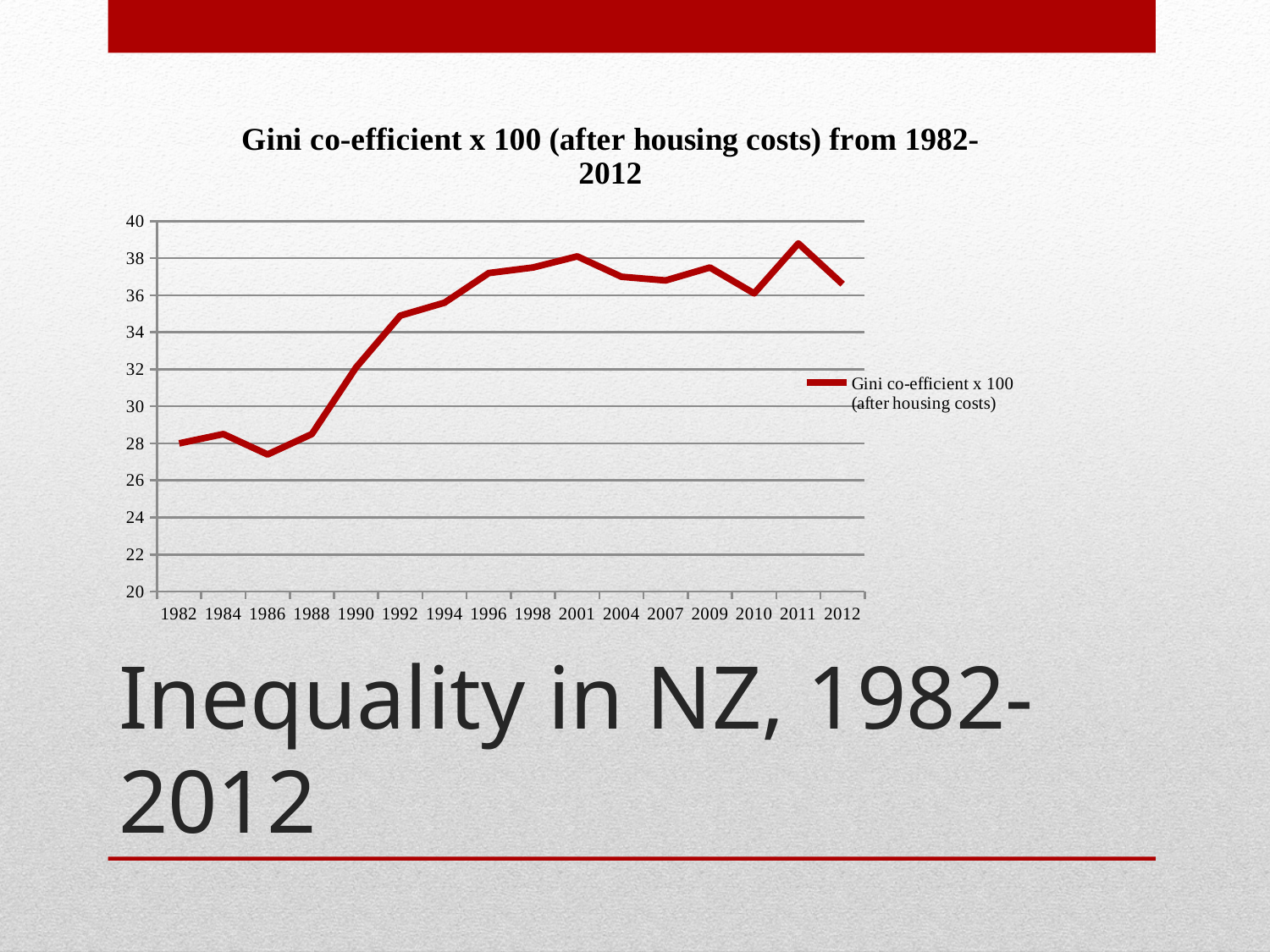
Is the value for 2011 greater or less than 38? greater Which year has the larger value, 1988 or 1996? 1996 What kind of chart is shown on the slide? line chart Does the Gini co-efficient x 100 generally rise or fall between 1988 and 2001? rise Is the value for 1986 greater or less than 28? less In which year is the Gini co-efficient x 100 highest? 2011 Is the value for 1990 greater or less than 30? greater What is the title of the chart? Gini co-efficient x 100 (after housing costs) from 1982-2012 In which year is the Gini co-efficient x 100 lowest? 1986 How many series does the legend list? 1 How many years are plotted along the x axis? 16